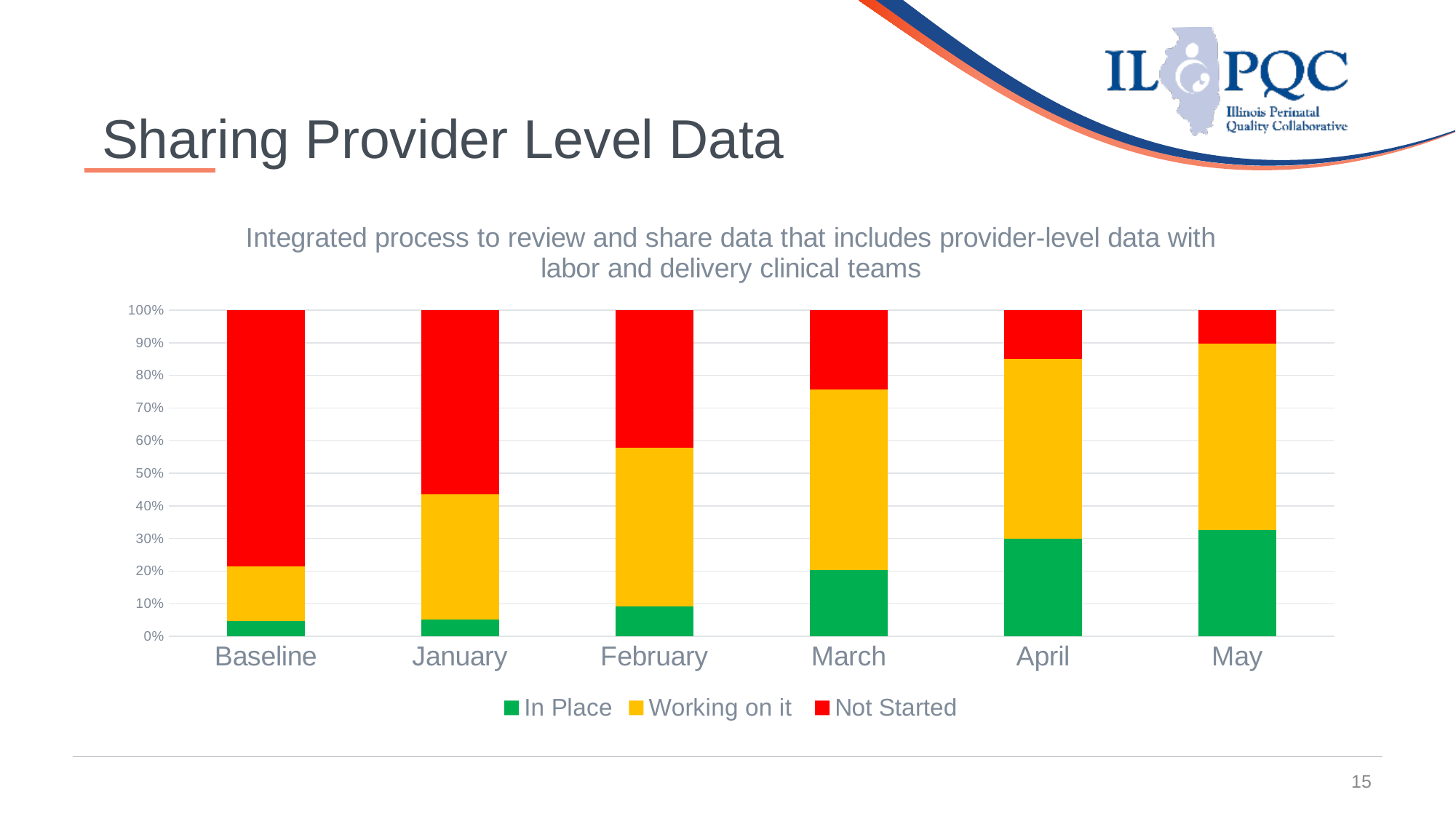
How many categories are shown along the x axis of the chart? 6 Which category has the largest 'Not Started' share? Baseline Which category has the smallest 'Not Started' share? May Which colour represents 'Not Started' in the legend? Red Is the 'In Place' share for Baseline greater or less than 10%? less Is the 'In Place' share for April greater or less than 20%? greater How many series does the chart's legend list? 3 Does the 'In Place' share rise or fall from Baseline to May? rise What does each stacked bar total? 100% Is the 'Not Started' share for Baseline greater or less than 70%? greater What kind of chart is shown on the slide? Stacked bar chart Which has the larger 'Not Started' share, January or February? January